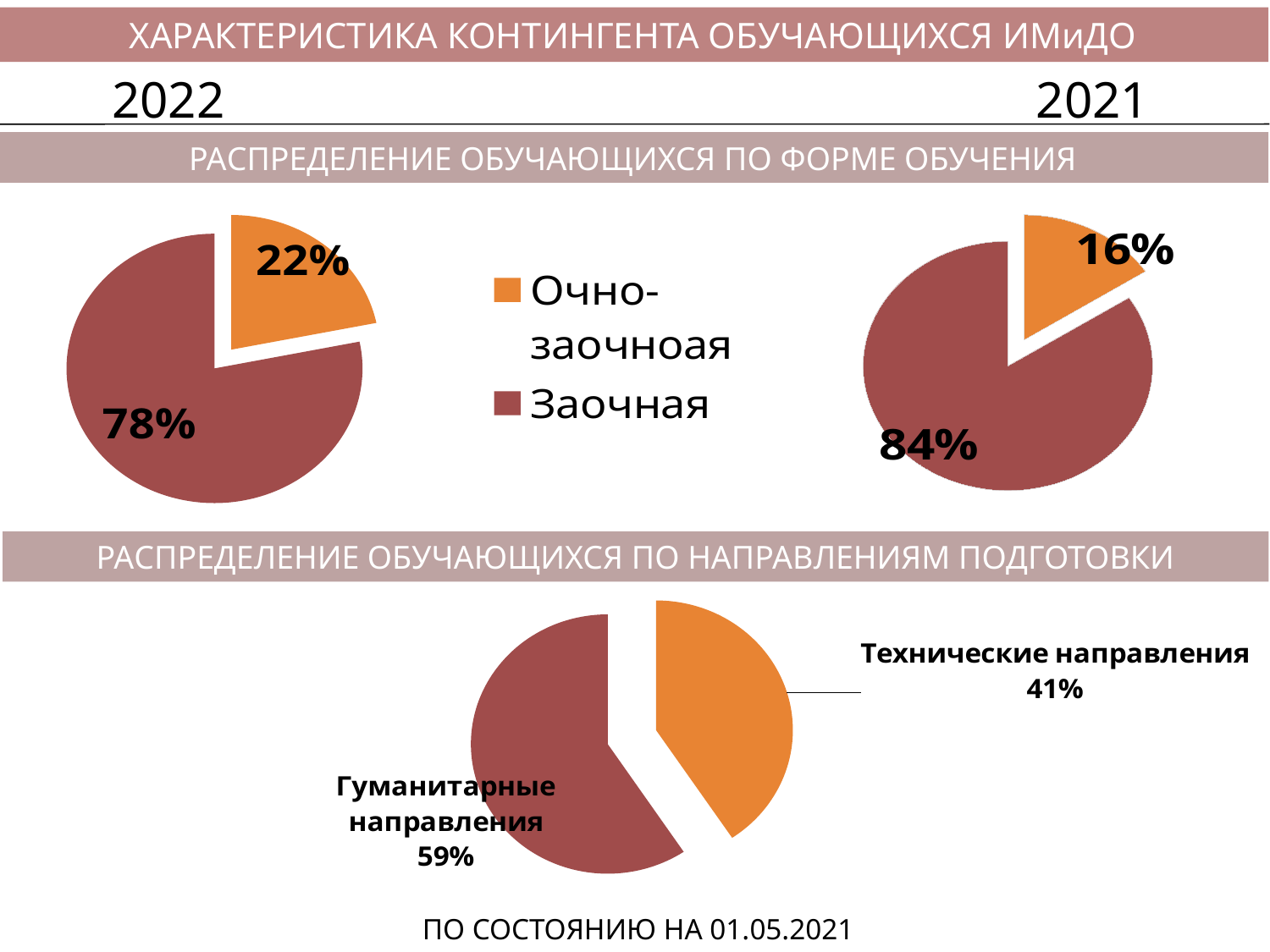
How many entries does the legend between the 2022 and 2021 form-of-study pie charts list? 2 What type of chart is used for the distribution by направления подготовки? Pie chart In the bottom pie chart on the distribution by направления подготовки, what share is Гуманитарные направления? 59% In the bottom pie chart on the distribution by направления подготовки, what share is Технические направления? 41% In the 2021 pie chart on the distribution by form of study, what share is Очно-заочная? 16% What is the difference between the Заочная share in 2021 and in 2022 in the form-of-study pie charts? 6% In the 2021 pie chart on the distribution by form of study, what share is Заочная? 84% In the 2022 pie chart on the distribution by form of study, what share is Заочная? 78% In the 2022 pie chart on form of study, which category has the largest share? Заочная In the bottom pie chart on направления подготовки, which category has the smallest share? Технические направления In the 2022 pie chart on the distribution by form of study, what share is Очно-заочная? 22% Is the Очно-заочная share larger in the 2022 pie chart or the 2021 pie chart? 2022